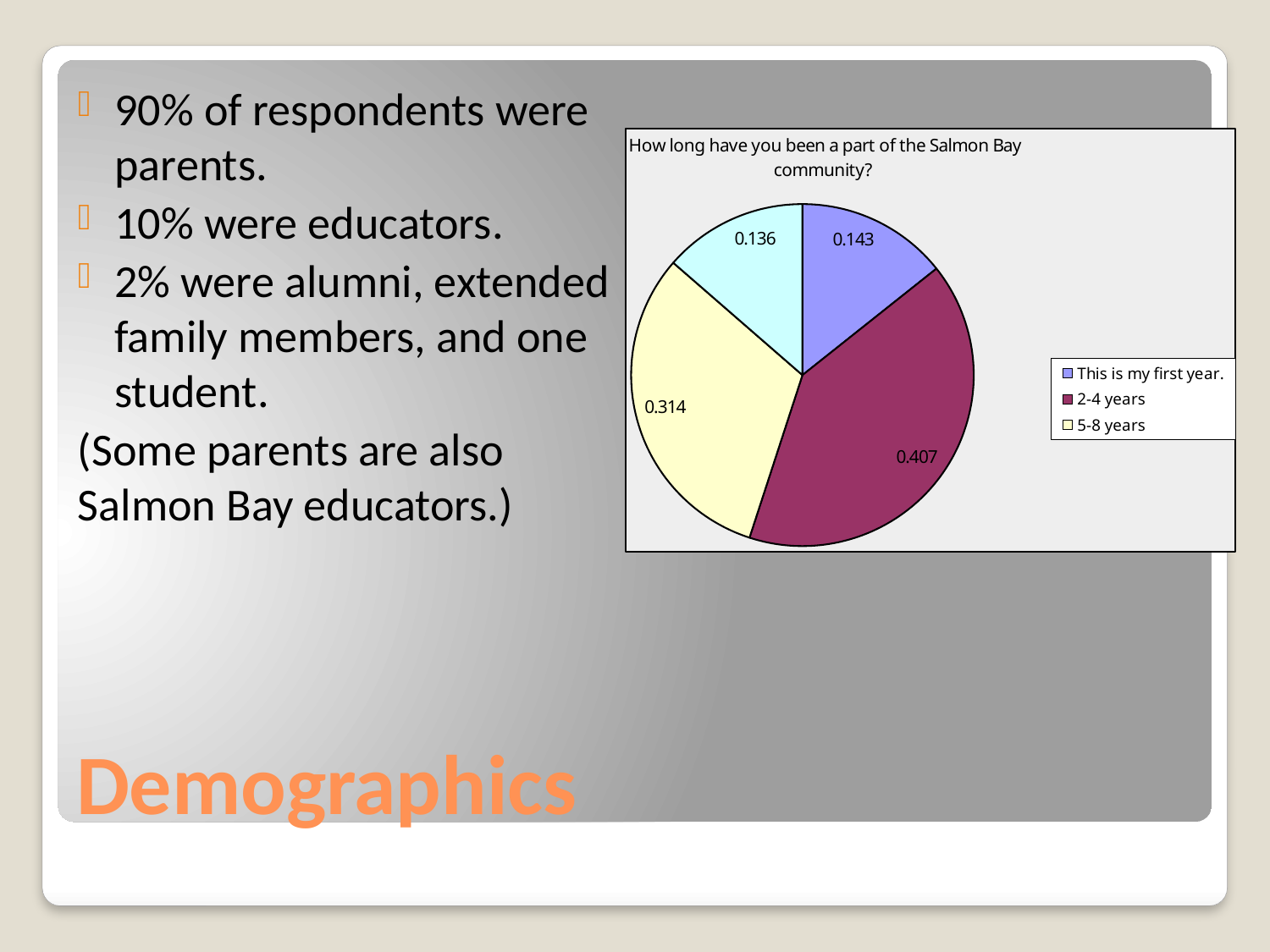
What is the title of the chart? How long have you been a part of the Salmon Bay community? What value is shown for the "This is my first year." slice? 0.143 What kind of chart is shown on the slide? pie chart What value is shown for the "2-4 years" slice? 0.407 Which is larger, the "5-8 years" slice or the "This is my first year." slice? 5-8 years How many entries does the chart's legend list? 3 Which category has the largest slice of the pie? 2-4 years What value is shown for the "5-8 years" slice? 0.314 What is the value printed on the smallest slice of the pie? 0.136 How many slices does the pie chart have? 4 What is the difference between the "2-4 years" value and the "5-8 years" value? 0.093 What is the difference between the "2-4 years" value and the "This is my first year." value? 0.264